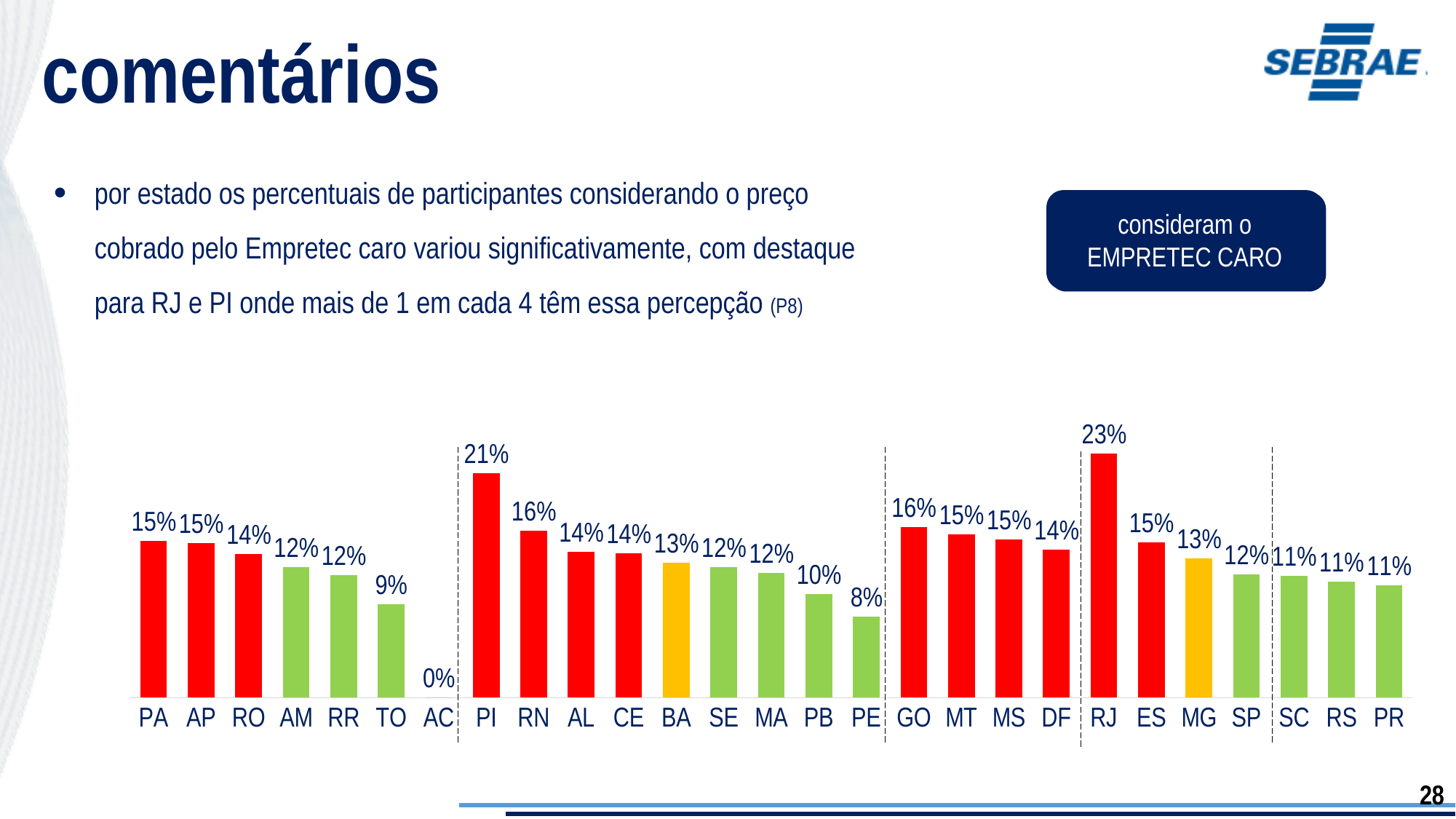
How many states are shown on the chart? 27 Which state has the lowest value? AC Which is larger, the value for RN or the value for TO? RN What is the value for PE? 8% What is the value for AC? 0% What is the value for RJ? 23% What is the difference between the values for RJ and PI? 2% What kind of chart is shown on the slide? Bar chart What is the value for PI? 21% What is the difference between the values for GO and PE? 8% What colour is the bar for BA? Yellow Which state has the highest value? RJ